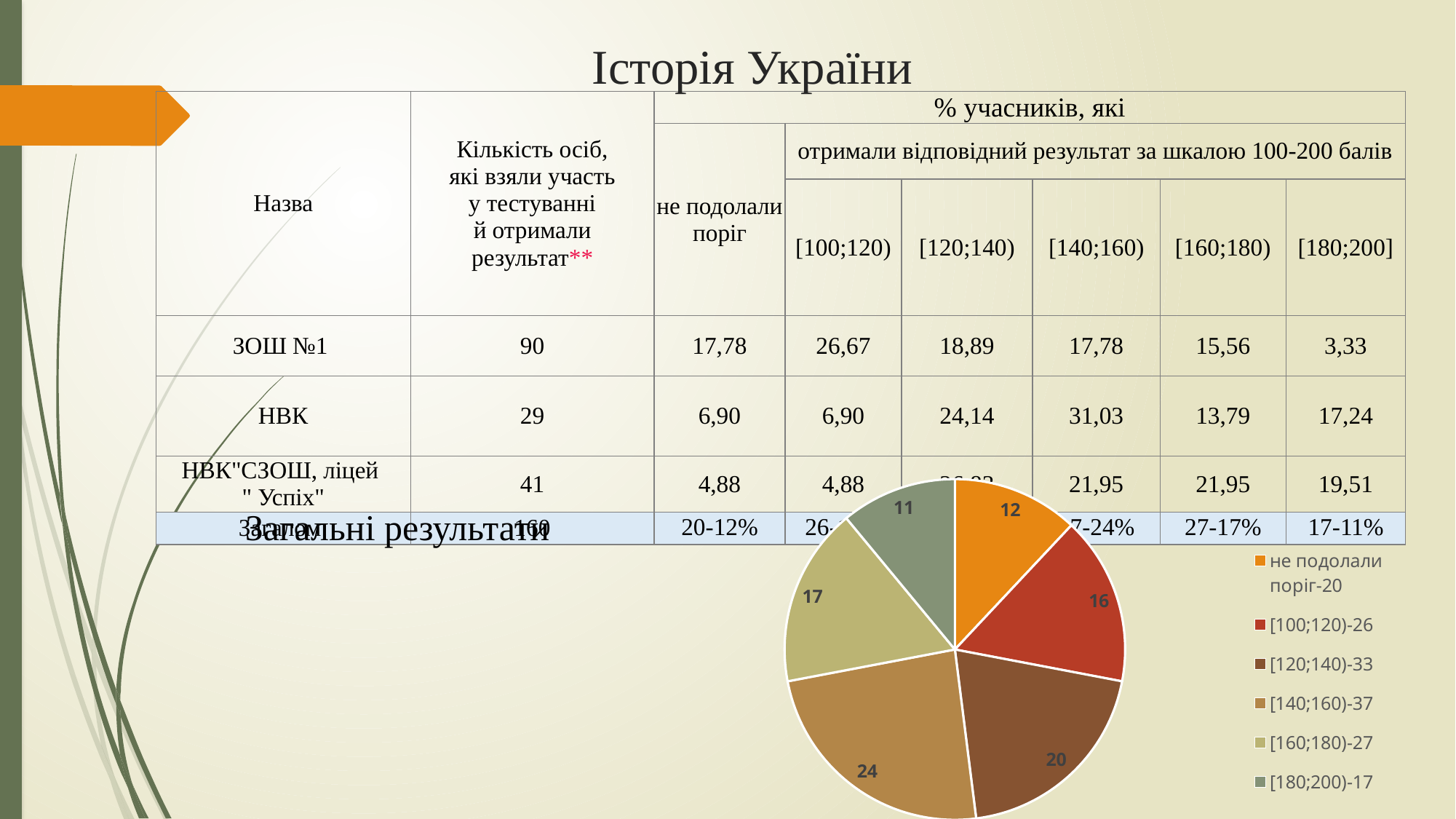
What is the data label on the pie slice for [120;140)-33? 20 How many slices does the pie chart have? 6 What is the difference between the data labels of the [140;160)-37 slice and the [100;120)-26 slice? 8 What is the data label on the pie slice for [180;200)-17? 11 What is the data label on the pie slice for [140;160)-37? 24 Which legend category has the smallest slice in the pie chart? [180;200)-17 What kind of chart is shown on the slide? pie chart Which slice has a larger data label: [160;180)-27 or [100;120)-26? [160;180)-27 What is the data label on the pie slice for 'не подолали поріг-20'? 12 What colour is the slice for [180;200)-17 in the pie chart? grey-green Which legend category has the largest slice in the pie chart? [140;160)-37 How many entries does the pie chart legend list? 6